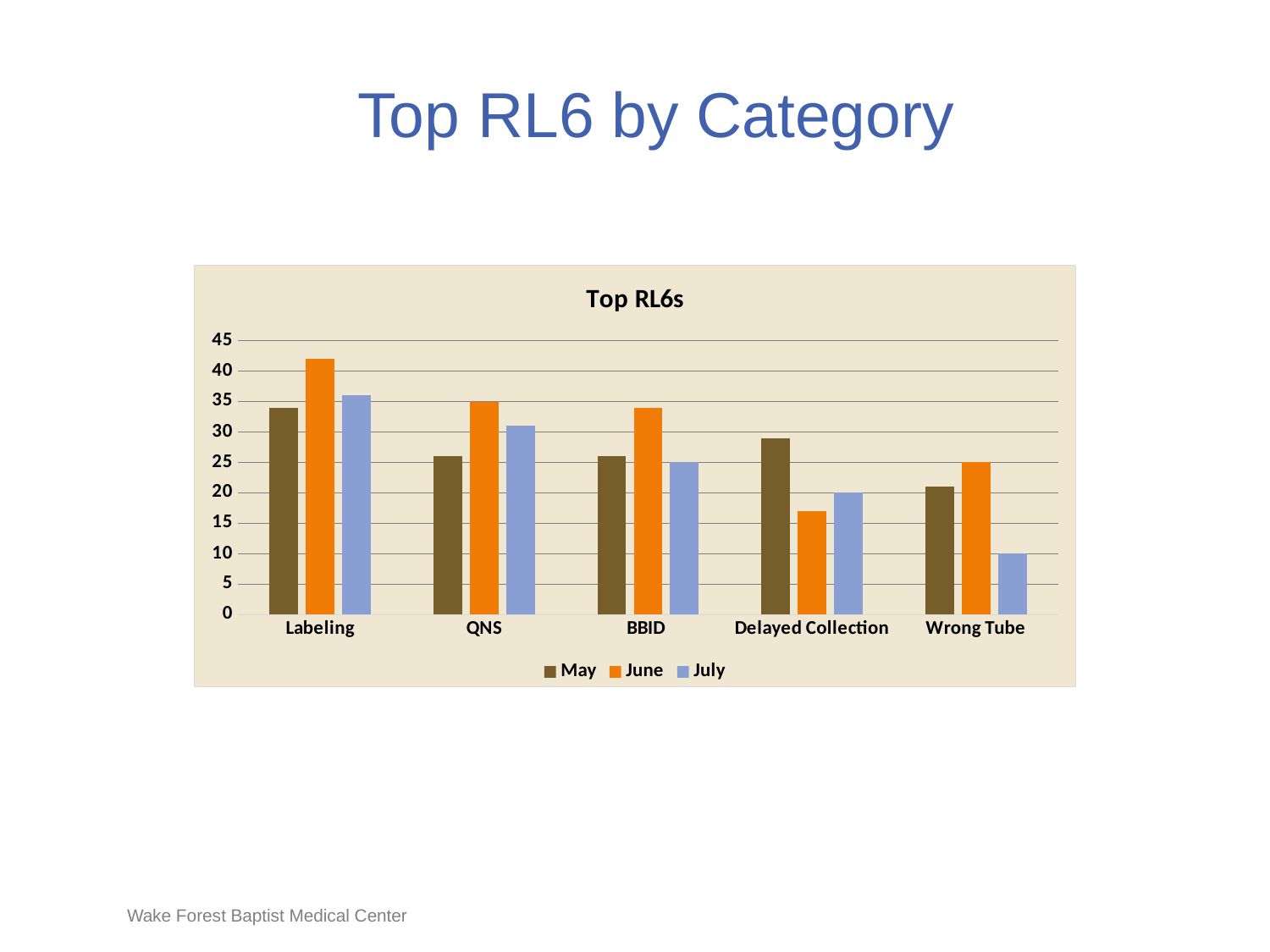
Which category has the lowest July value? Wrong Tube What is the title shown inside the chart area? Top RL6s How many categories are shown on the x axis? 5 Which series is shown in orange? June Is the May value for Delayed Collection greater or less than 25? greater How many series does the legend list? 3 What kind of chart is shown on the slide? bar chart Is the June value for Labeling greater or less than 40? greater Which is larger for QNS, the June value or the July value? June Which is larger for Delayed Collection, the May value or the June value? May Is the June value for Delayed Collection greater or less than 20? less Which category has the highest June value? Labeling